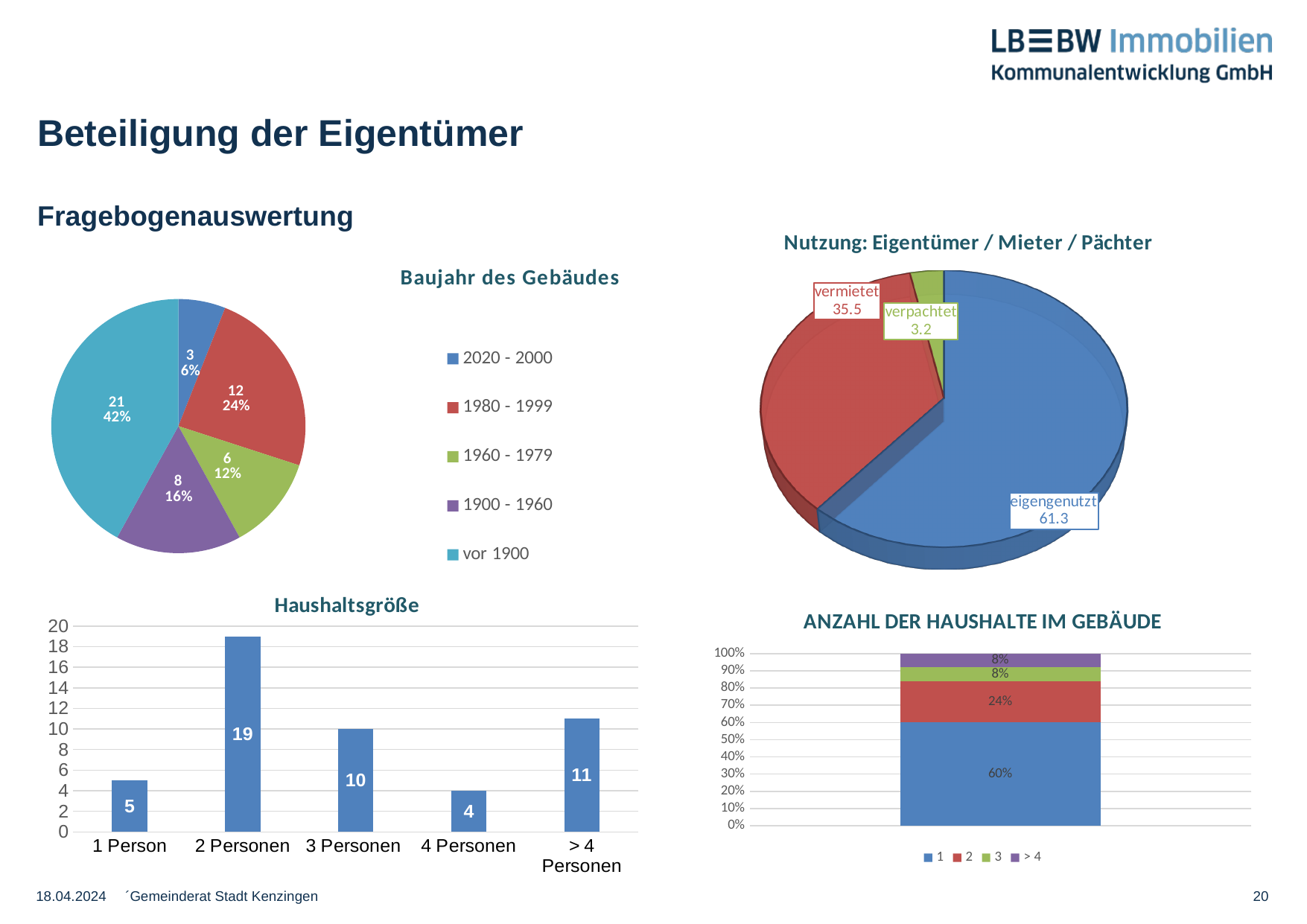
In the 'Haushaltsgröße' bar chart, which category has the highest value? 2 Personen In the 'Nutzung: Eigentümer / Mieter / Pächter' pie chart, what is the difference between 'eigengenutzt' and 'vermietet'? 25.8 In the 'Baujahr des Gebäudes' pie chart, what share does 'vor 1900' have? 42% What kind of chart is 'Haushaltsgröße'? Bar chart In the 'Nutzung: Eigentümer / Mieter / Pächter' pie chart, what is the value for 'vermietet'? 35.5 In the 'Haushaltsgröße' bar chart, what is the value for '3 Personen'? 10 In the 'Haushaltsgröße' bar chart, what is the difference between '2 Personen' and '> 4 Personen'? 8 How many categories does the legend of the 'Baujahr des Gebäudes' pie chart list? 5 In the 'Baujahr des Gebäudes' pie chart, which category has the smallest slice? 2020 - 2000 In the 'ANZAHL DER HAUSHALTE IM GEBÄUDE' chart, what is the share for series '1'? 60% In the 'Nutzung: Eigentümer / Mieter / Pächter' pie chart, which category has the largest slice? eigengenutzt In the 'Baujahr des Gebäudes' pie chart, what is the value for '1980 - 1999'? 12